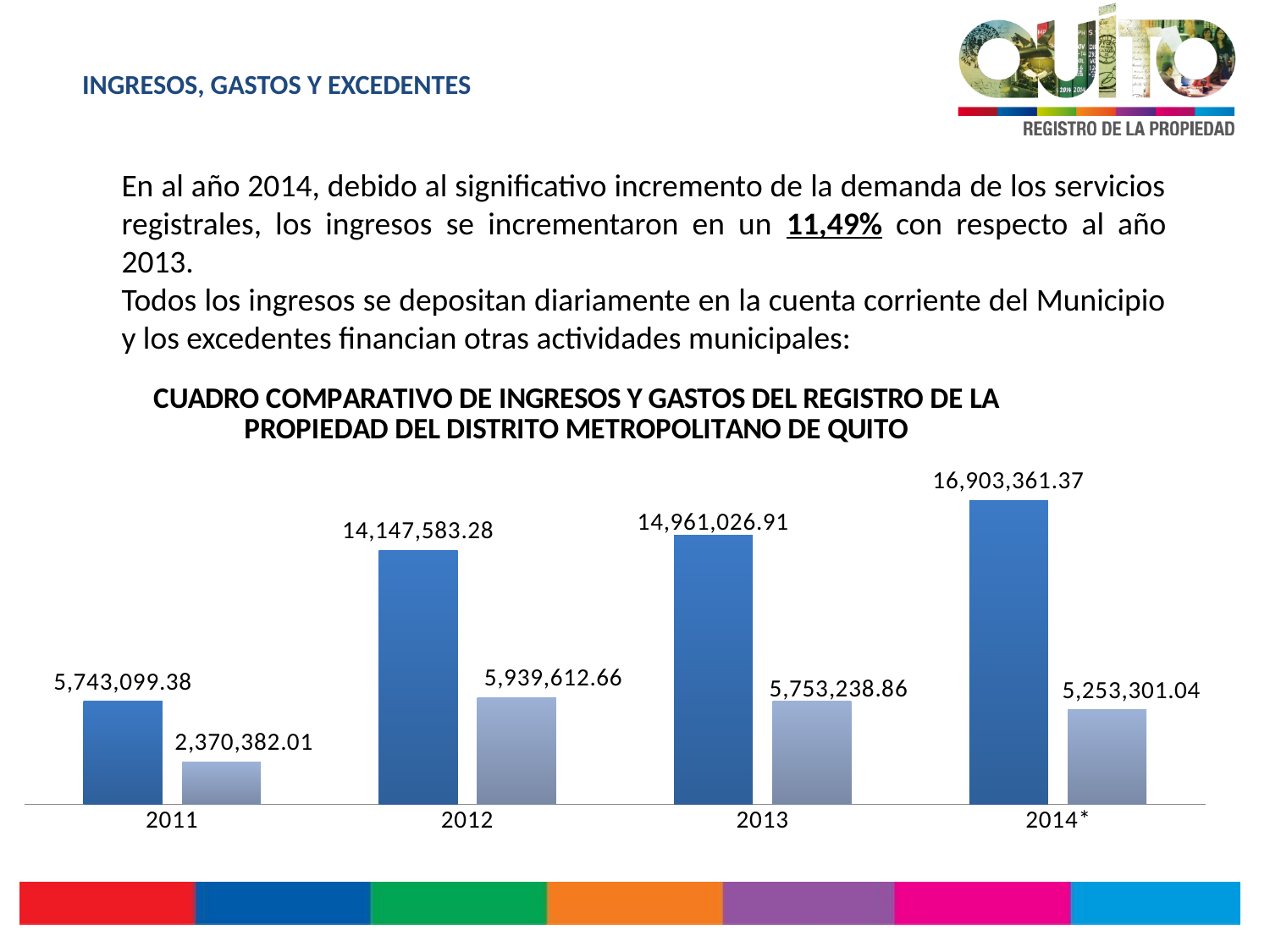
Which year has the lowest light blue bar? 2011 What is the value of the dark blue bar for 2014*? 16,903,361.37 Do the dark blue bars rise or fall from 2011 to 2014*? rise What is the value of the light blue bar for 2013? 5,753,238.86 Which year has the highest dark blue bar? 2014* What is the difference between the dark blue and light blue bars for 2014*? 11,650,060.33 How many years are shown on the x axis of the chart? 4 Which is larger, the light blue bar for 2012 or the light blue bar for 2014*? 2012 What is the value of the dark blue bar for 2011? 5,743,099.38 What is the value of the light blue bar for 2012? 5,939,612.66 What kind of chart is shown on the slide? bar chart What is the difference between the dark blue bar for 2013 and the dark blue bar for 2012? 813,443.63